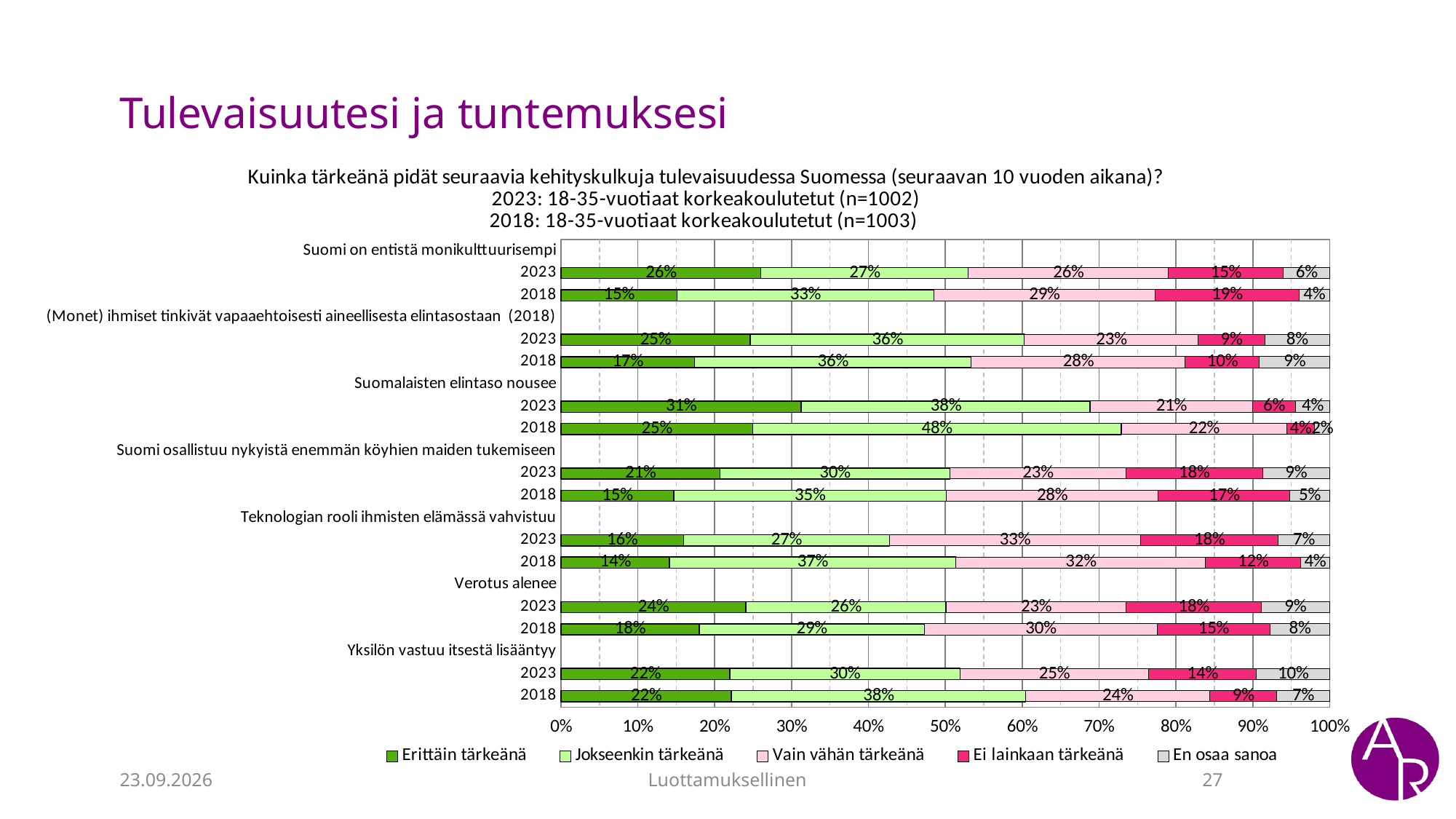
Which is larger: the 'Vain vähän tärkeänä' share for 'Teknologian rooli ihmisten elämässä vahvistuu' in 2023 or for 'Verotus alenee' in 2023? Teknologian rooli ihmisten elämässä vahvistuu (33%) How many statements (categories) are shown in the chart? 7 What is the 'Ei lainkaan tärkeänä' share for 'Suomi on entistä monikulttuurisempi' in 2018? 19% By how many percentage points did the 'Erittäin tärkeänä' share for 'Suomi on entistä monikulttuurisempi' change from 2018 to 2023? 11 percentage points What is the 'En osaa sanoa' share for 'Yksilön vastuu itsestä lisääntyy' in 2023? 10% What is the 'Erittäin tärkeänä' share for 'Suomalaisten elintaso nousee' in 2023? 31% What is the 'Jokseenkin tärkeänä' share for 'Suomalaisten elintaso nousee' in 2018? 48% What is the combined share of 'Erittäin tärkeänä' and 'Jokseenkin tärkeänä' for 'Verotus alenee' in 2023? 50% How many series does the legend list? 5 Which statement has the highest 'Erittäin tärkeänä' share in 2023? Suomalaisten elintaso nousee What kind of chart is shown on the slide? Stacked bar chart Which statement has the lowest 'Erittäin tärkeänä' share in 2018? Teknologian rooli ihmisten elämässä vahvistuu